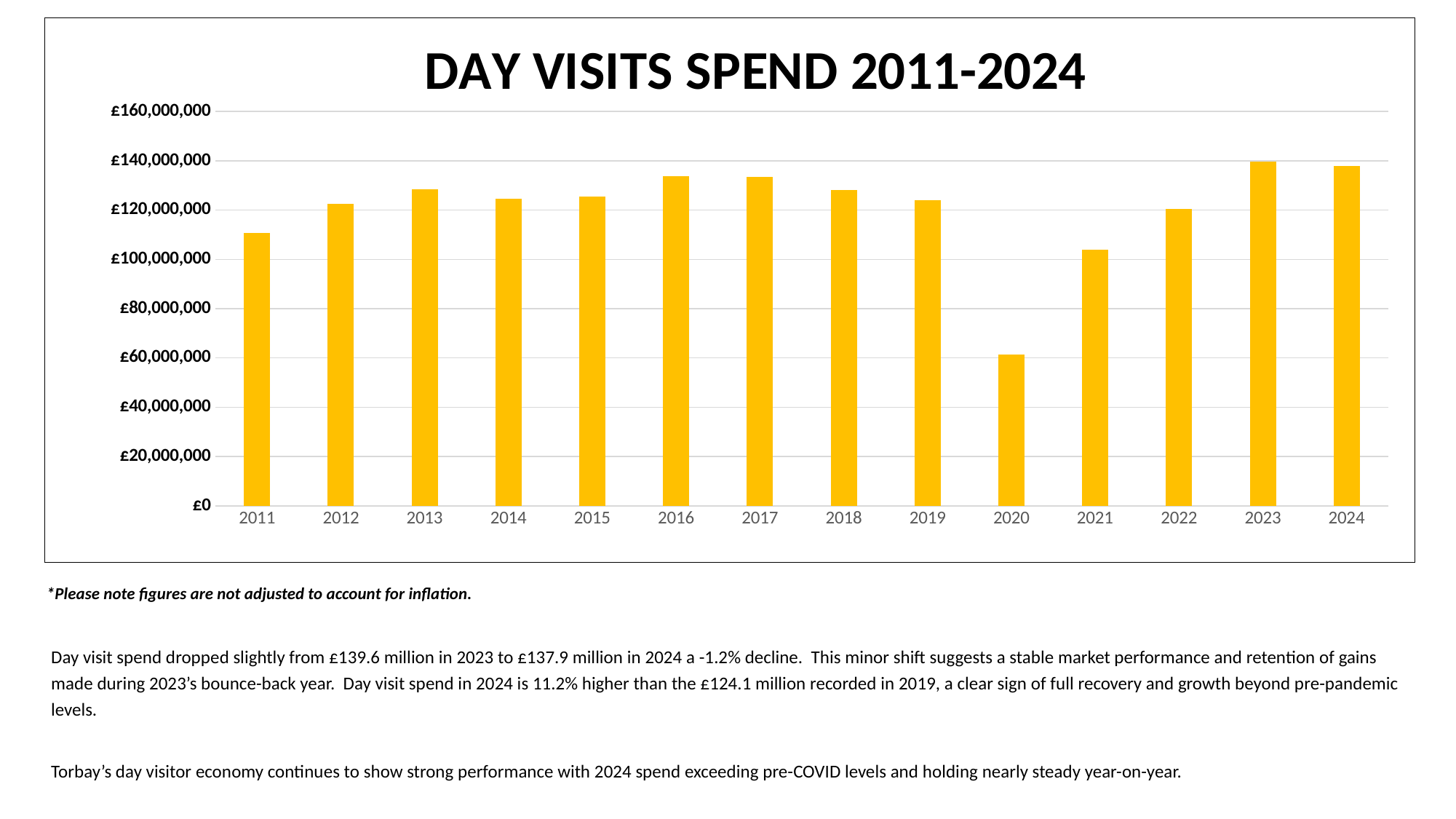
Does the day visits spend rise or fall from 2019 to 2020? fall Which year has the highest day visits spend? 2023 Which year has the larger day visits spend, 2020 or 2021? 2021 What kind of chart is shown on the slide? bar chart Which year has the lowest day visits spend? 2020 Is the value for 2016 greater or less than £120,000,000? greater Which year has the larger day visits spend, 2011 or 2012? 2012 How many years are plotted on the chart? 14 According to the slide, what was the day visit spend in 2023? £139.6 million Is the value for 2011 greater or less than £100,000,000? greater Is the value for 2020 greater or less than £80,000,000? less What is the title of the chart? DAY VISITS SPEND 2011-2024